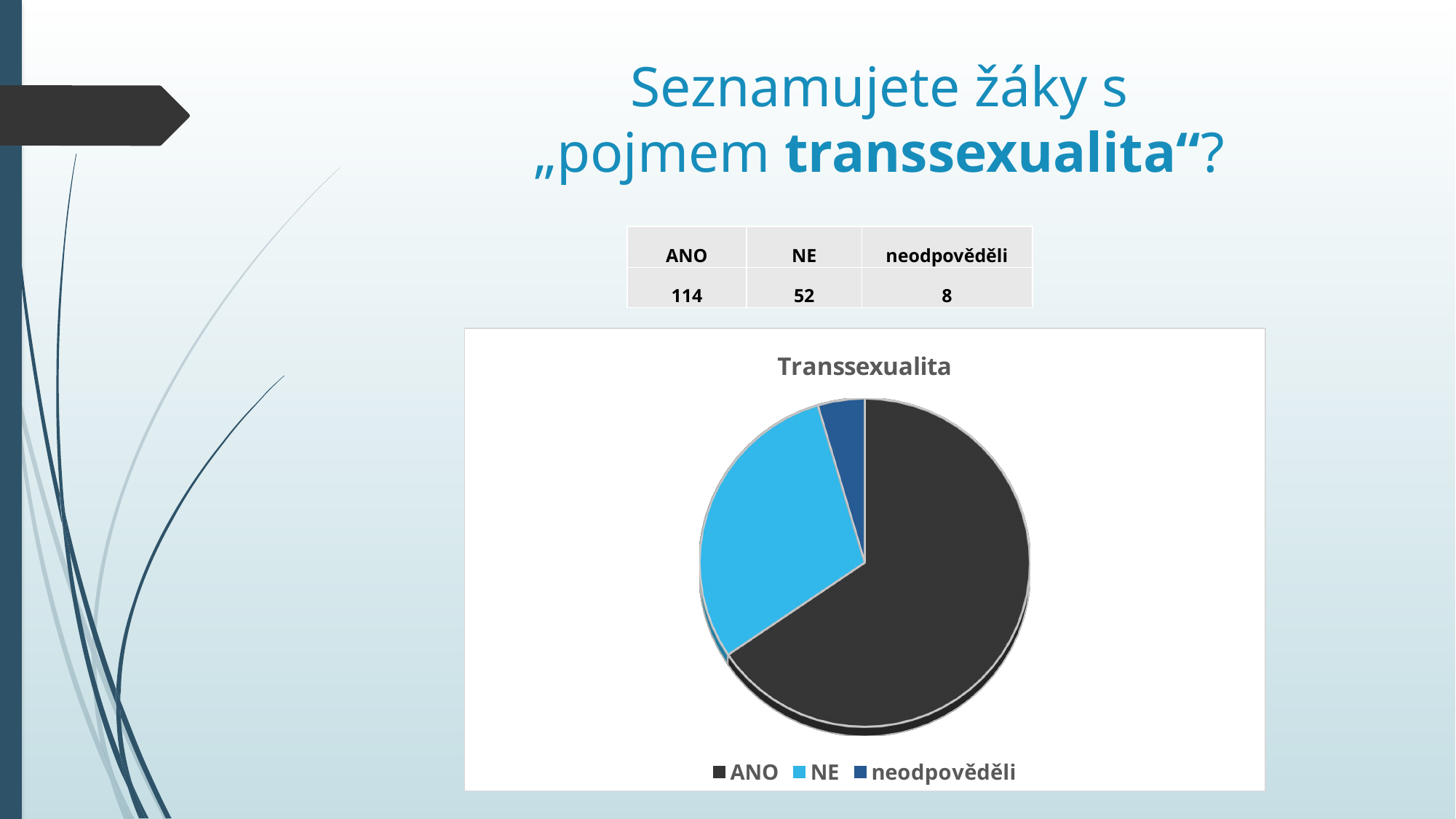
Which category has the smallest slice of the pie? neodpověděli Which category has the largest slice of the pie? ANO How many slices does the pie chart have? 3 What is the value for neodpověděli? 8 What is the total of all three categories in the chart? 174 What is the value for NE? 52 What is the title of the chart? Transsexualita How many entries does the chart legend list? 3 What is the value for ANO? 114 What kind of chart is shown on the slide? pie chart What is the difference between the values for ANO and NE? 62 Which is larger, the value for NE or the value for neodpověděli? NE